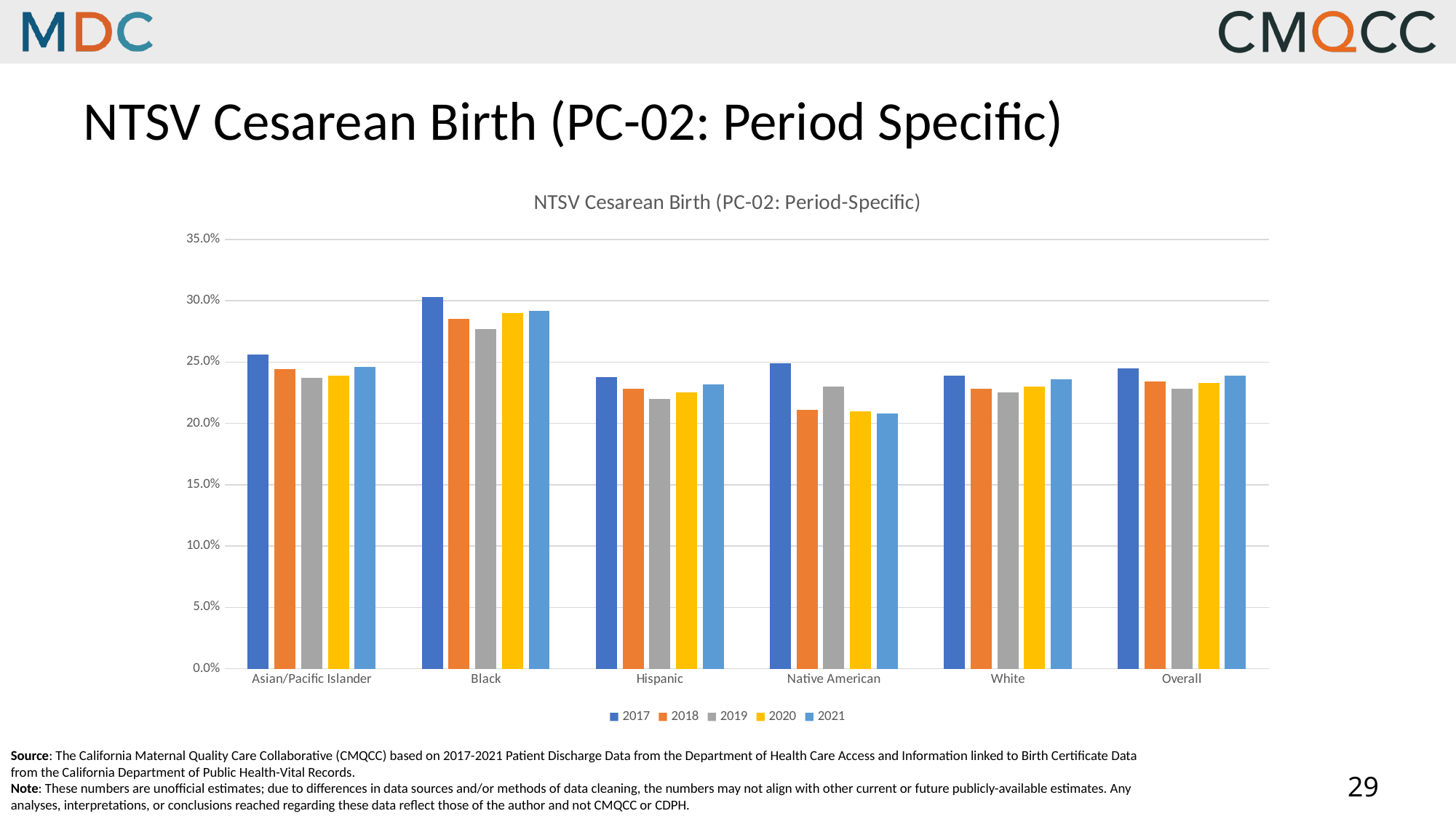
What kind of chart is shown on the slide? bar chart What is the title of the chart? NTSV Cesarean Birth (PC-02: Period-Specific) How many categories are shown on the x axis? 6 Which category has the lowest value for 2021? Native American Which is larger, the 2019 value for Black or the 2019 value for Hispanic? Black Is the 2021 value for Native American greater or less than 25.0%? less For the Overall category, which is larger, the 2017 value or the 2021 value? 2017 Is the 2017 value for Black greater or less than 25.0%? greater For the Black category, which year has the highest value? 2017 How many series does the legend list? 5 Is the 2019 value for Hispanic greater or less than 25.0%? less Which category has the highest value for 2017? Black